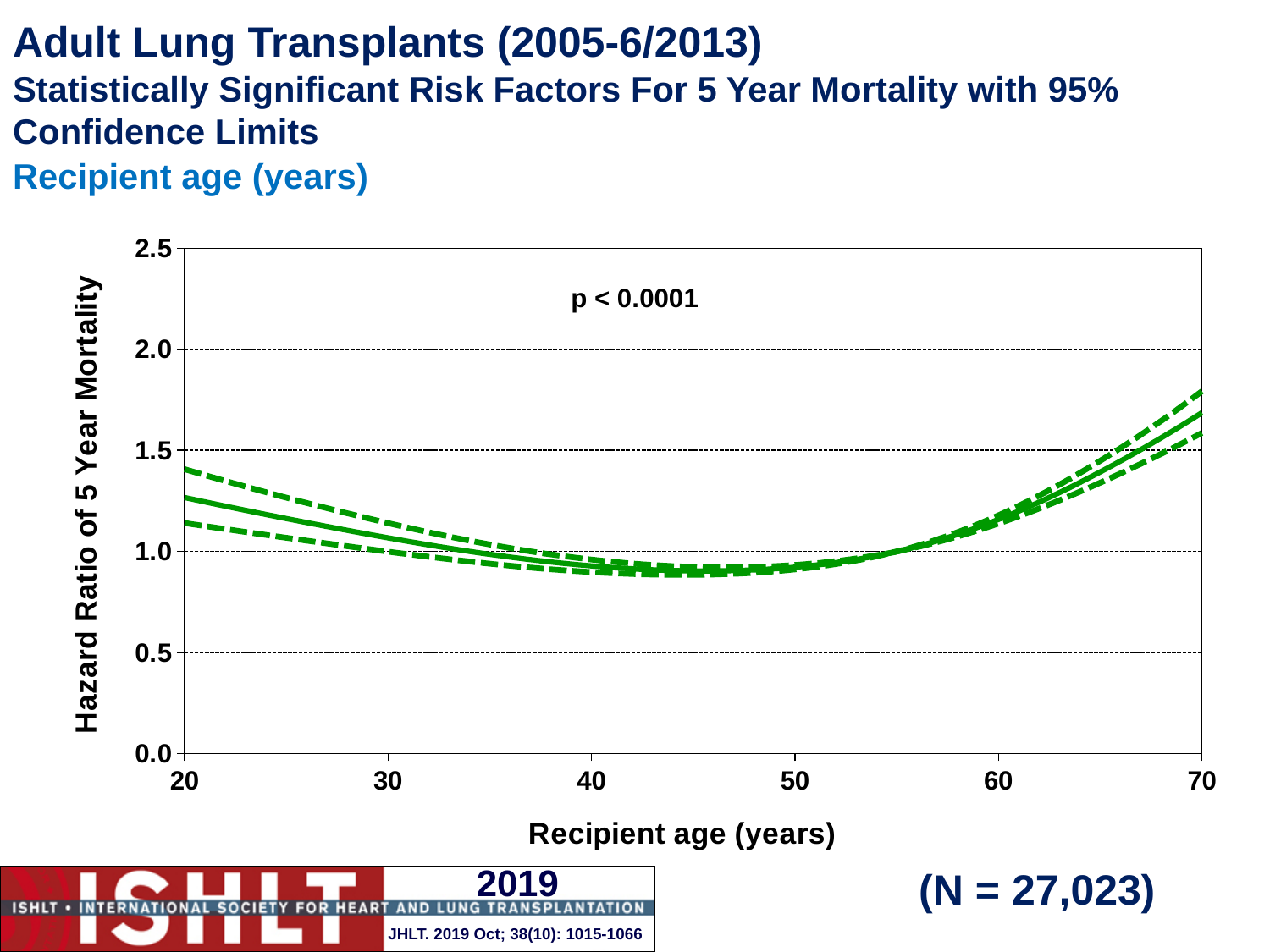
What p-value is printed on the chart? p < 0.0001 What kind of chart is shown on the slide? line chart Which recipient age has the larger hazard ratio, 20 or 70? 70 Is the hazard ratio for a recipient age of 60 greater or less than 1.0? greater Is the hazard ratio for a recipient age of 70 greater or less than 1.5? greater Does the hazard ratio rise or fall as recipient age increases from 50 to 70? rise Is the hazard ratio for a recipient age of 45 greater or less than 1.0? less How many lines are plotted on the chart? 3 What is the label of the y axis? Hazard Ratio of 5 Year Mortality Does the hazard ratio rise or fall as recipient age increases from 20 to 45? fall